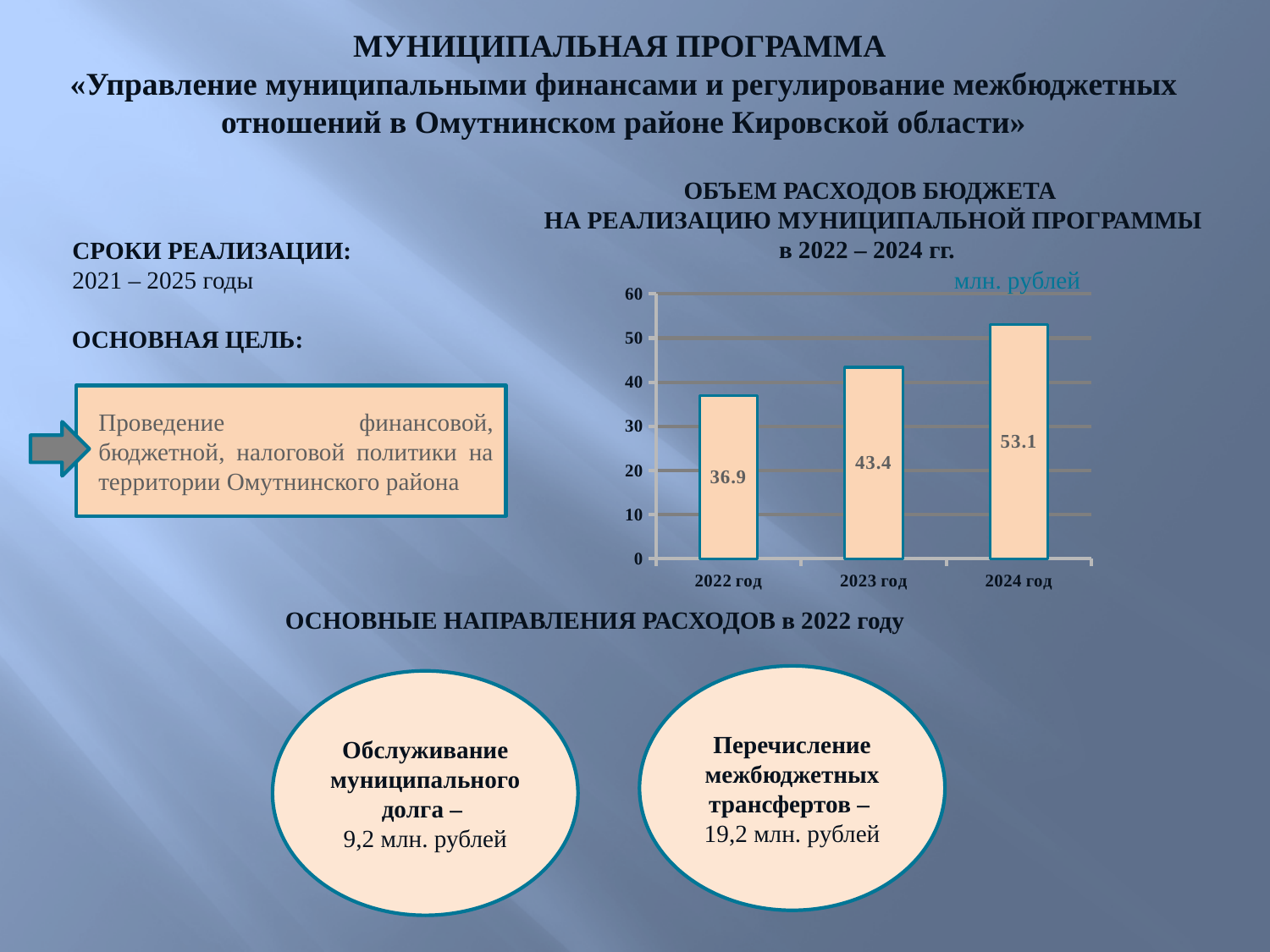
What is the value for 2024 год in the chart? 53.1 Is the value for 2024 год greater or less than 50? greater Which year has the lowest value in the chart? 2022 год Which is larger, the value for 2023 год or the value for 2024 год? 2024 год What is the difference between the values for 2023 год and 2022 год? 6.5 What kind of chart is shown on the slide? bar chart What is the difference between the values for 2024 год and 2022 год? 16.2 What is the value for 2023 год in the chart? 43.4 How many bars are shown in the chart? 3 What is the value for 2022 год in the chart? 36.9 Which year has the highest value in the chart? 2024 год Do the values rise or fall from 2022 год to 2024 год? rise